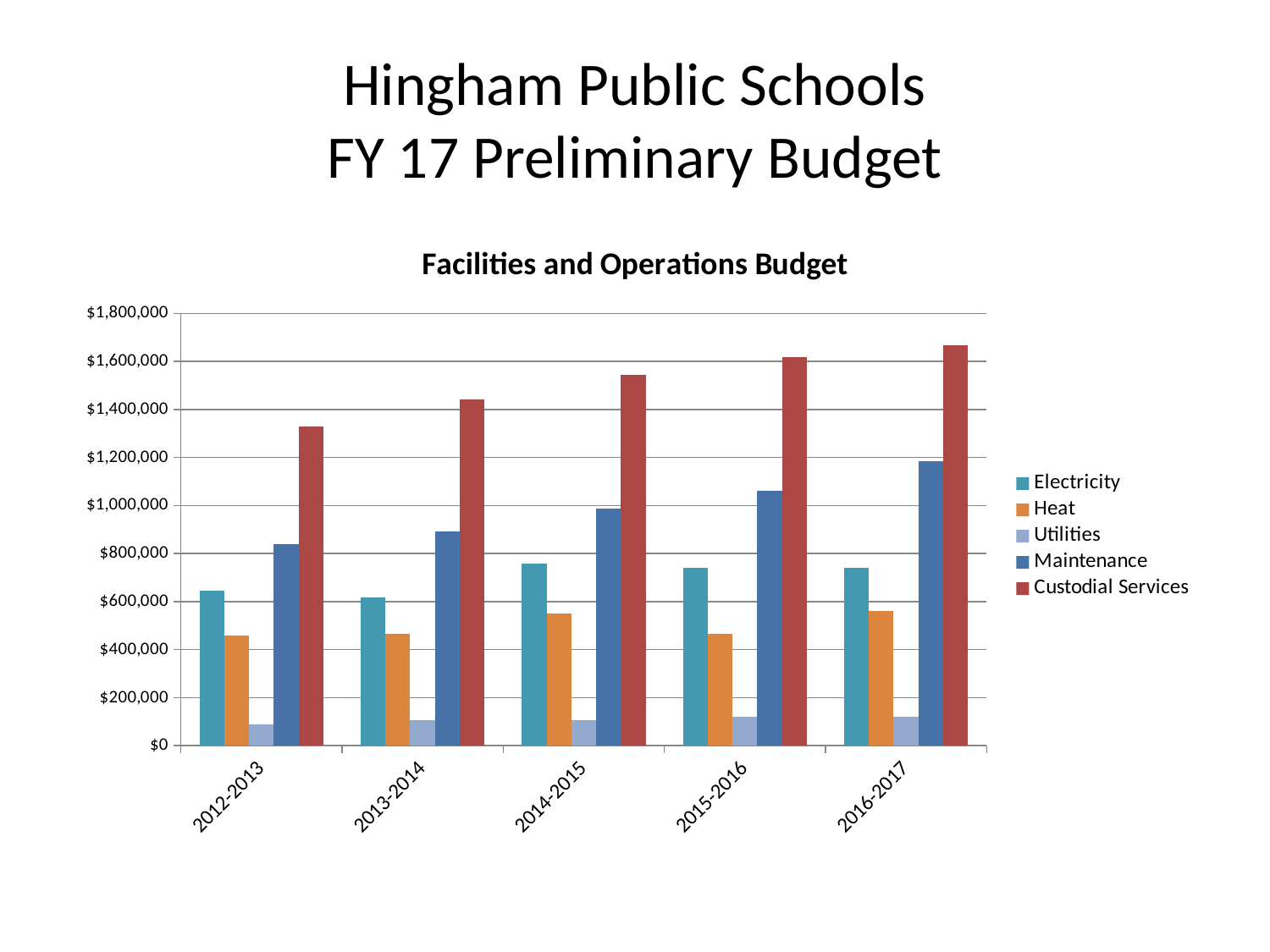
How many fiscal years are shown on the x axis? 5 How many series does the legend list? 5 Is the value for Electricity in 2014-2015 greater or less than $600,000? greater Is the value for Maintenance in 2012-2013 greater or less than $1,000,000? less Which series has the lowest value in 2012-2013? Utilities Which series has the highest value in 2016-2017? Custodial Services Which is larger: Custodial Services in 2012-2013 or Custodial Services in 2016-2017? 2016-2017 Do the Custodial Services values rise or fall from 2012-2013 to 2016-2017? Rise What is the title of the chart? Facilities and Operations Budget Do the Maintenance values rise or fall across the years shown? Rise Is the value for Custodial Services in 2016-2017 greater or less than $1,600,000? greater What kind of chart is shown on the slide? Bar chart